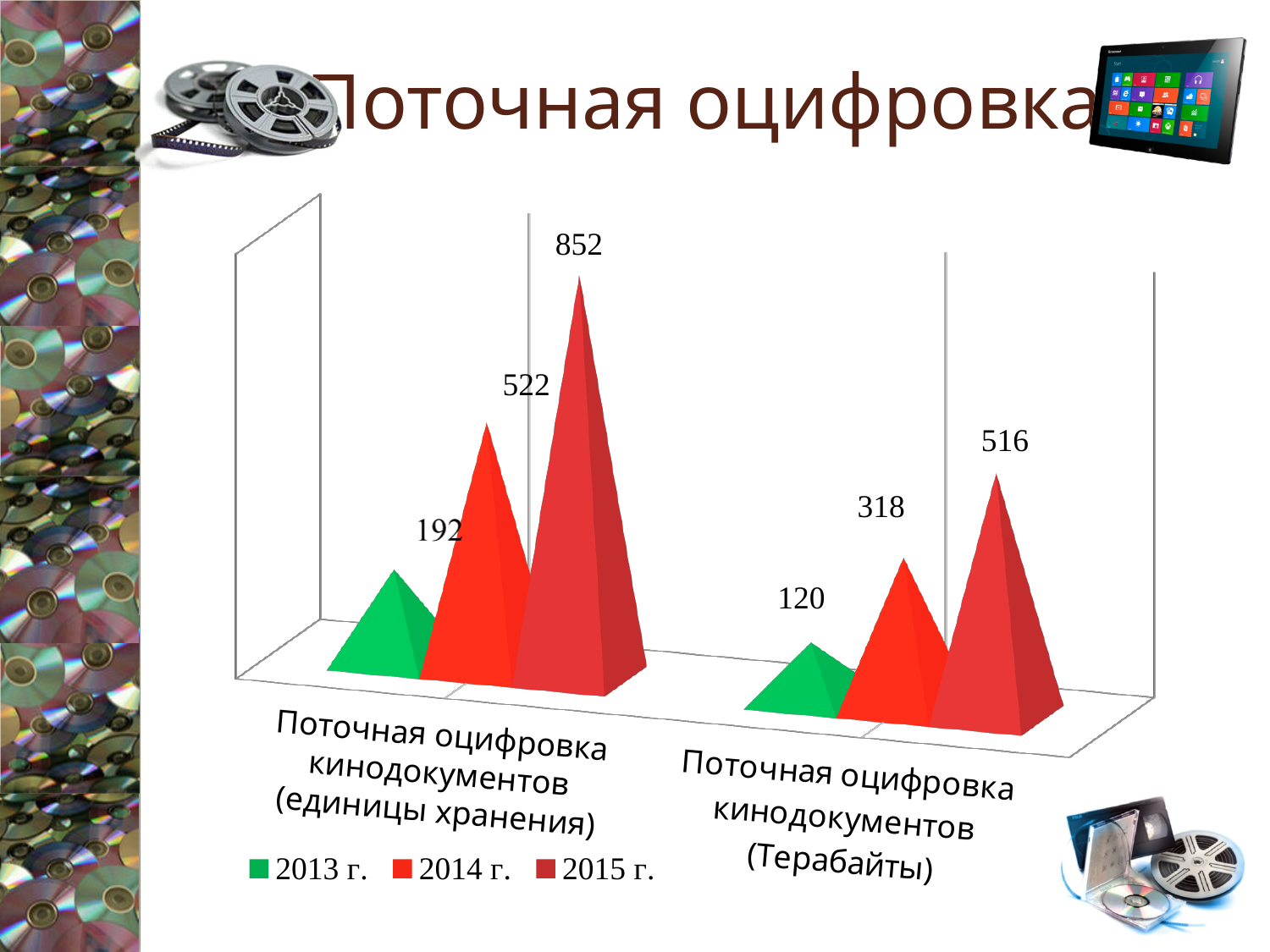
How many series does the legend list? 3 Do the values rise or fall from 2013 г. to 2015 г. in the category "Поточная оцифровка кинодокументов (Терабайты)"? rise What is the value for 2015 г. in the category "Поточная оцифровка кинодокументов (единицы хранения)"? 852 What is the value for 2013 г. in the category "Поточная оцифровка кинодокументов (Терабайты)"? 120 What is the difference between the 2015 г. and 2014 г. values in the category "Поточная оцифровка кинодокументов (единицы хранения)"? 330 Which year has the lowest value in the category "Поточная оцифровка кинодокументов (Терабайты)"? 2013 г. What is the difference between the 2015 г. and 2013 г. values in the category "Поточная оцифровка кинодокументов (Терабайты)"? 396 What is the value for 2014 г. in the category "Поточная оцифровка кинодокументов (Терабайты)"? 318 How many categories are shown on the x axis? 2 Which is larger: the 2013 г. value for "единицы хранения" or the 2013 г. value for "Терабайты"? единицы хранения What is the value for 2014 г. in the category "Поточная оцифровка кинодокументов (единицы хранения)"? 522 Which year has the highest value in the category "Поточная оцифровка кинодокументов (единицы хранения)"? 2015 г.